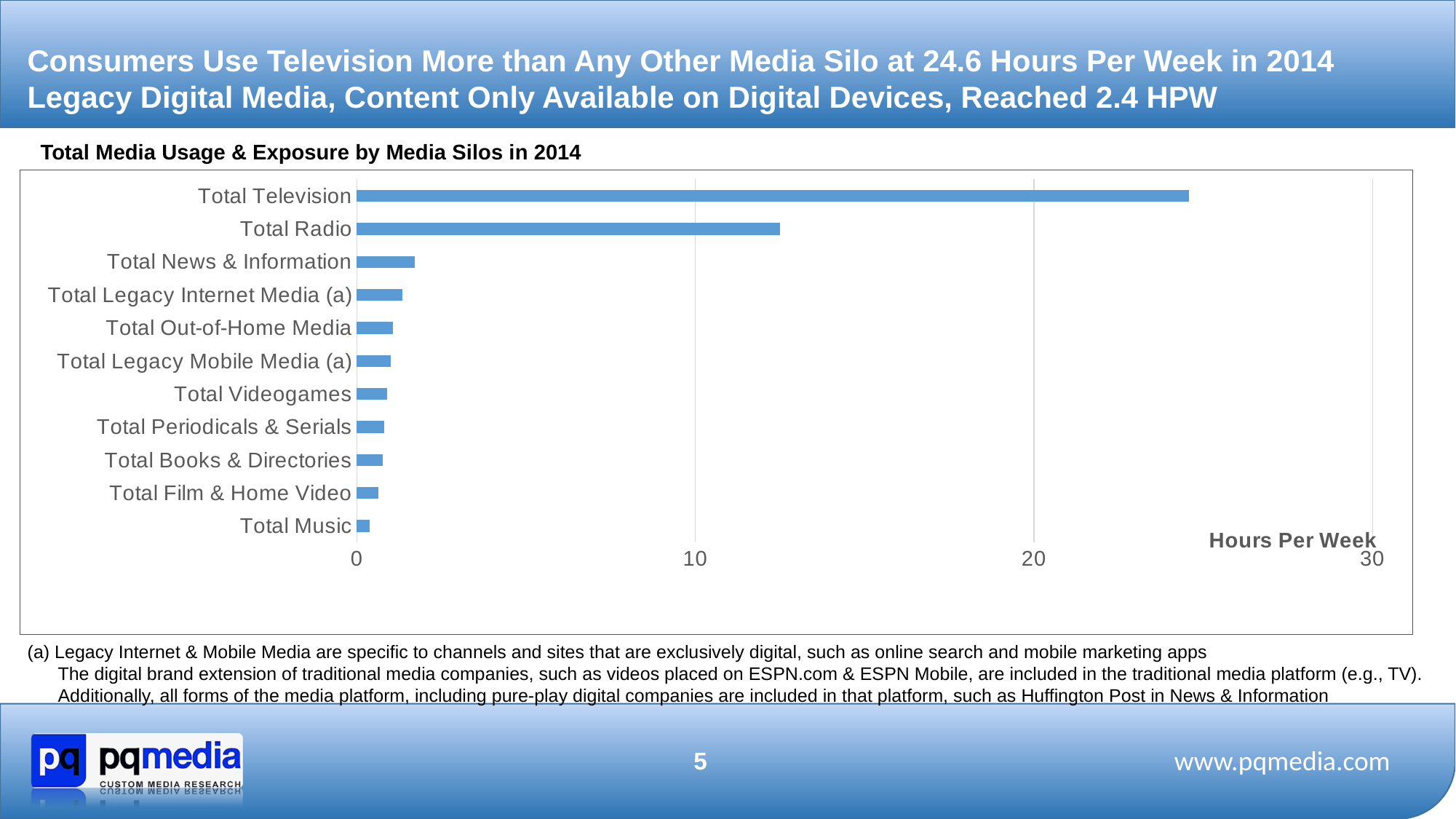
What kind of chart is shown on the slide? Bar chart Is the value for Total Radio greater or less than 20 hours per week? less Is the value for Total News & Information greater or less than 10 hours per week? less What is the title of the chart? Total Media Usage & Exposure by Media Silos in 2014 Which is larger, the value for Total Television or Total Radio? Total Television Which media silo has the lowest hours per week? Total Music How many media silos (categories) are plotted in the chart? 11 What is the label on the horizontal axis of the chart? Hours Per Week Is the value for Total Television greater or less than 20 hours per week? greater Which media silo has the highest hours per week? Total Television Which is larger, the value for Total Radio or Total News & Information? Total Radio